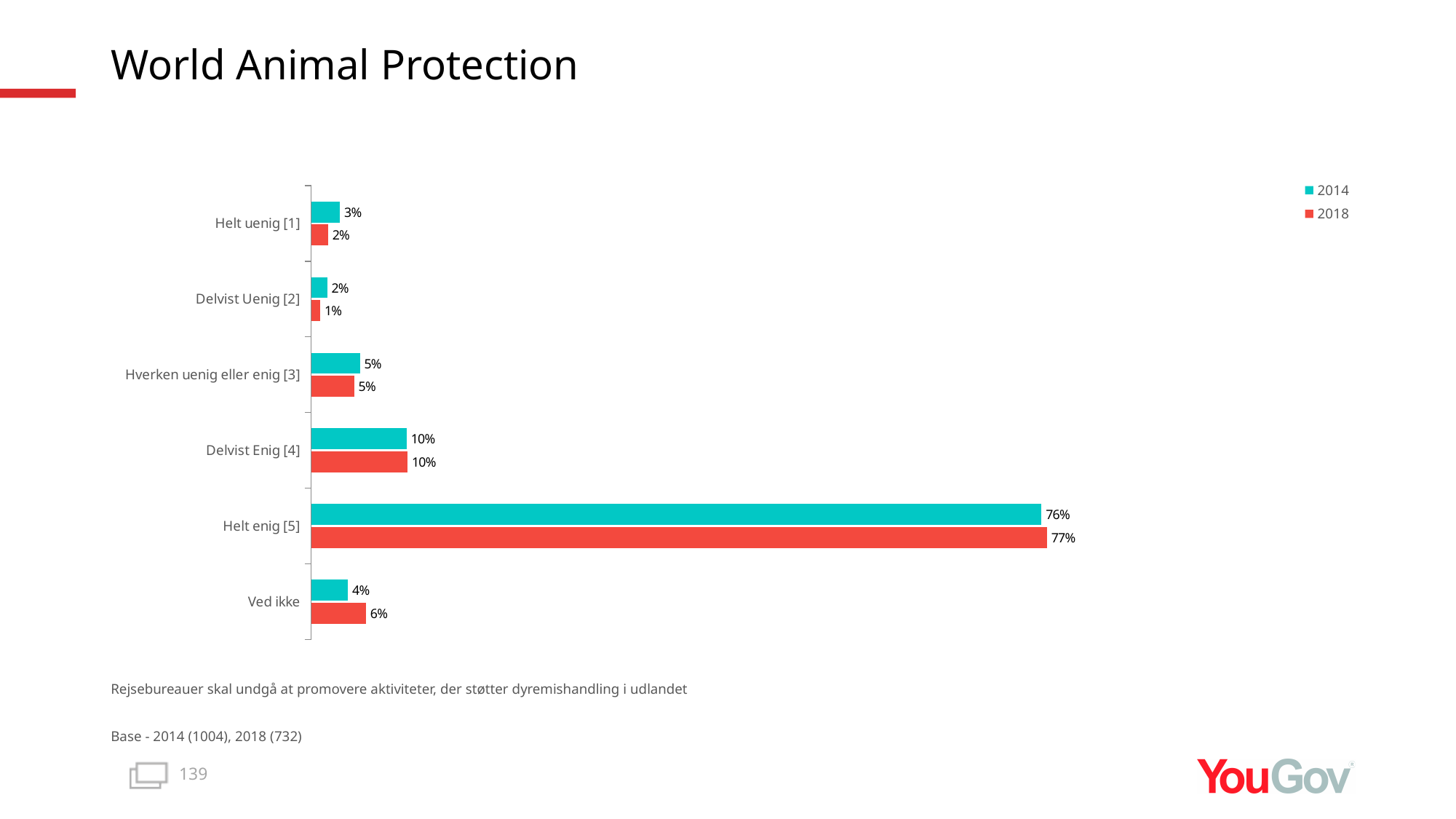
What kind of chart is shown on the slide? Bar chart Which is larger for Helt uenig [1], the 2014 value or the 2018 value? 2014 What is the 2018 value for Ved ikke? 6% Which category has the lowest 2014 value? Delvist Uenig [2] How many categories are shown on the chart? 6 What is the 2018 value for Delvist Uenig [2]? 1% What is the 2014 value for Helt enig [5]? 76% Which category has the highest 2018 value? Helt enig [5] What is the 2014 value for Delvist Enig [4]? 10% How many series does the legend list? 2 Which colour represents the 2018 series? Red What is the difference between the 2018 and 2014 values for Ved ikke? 2%